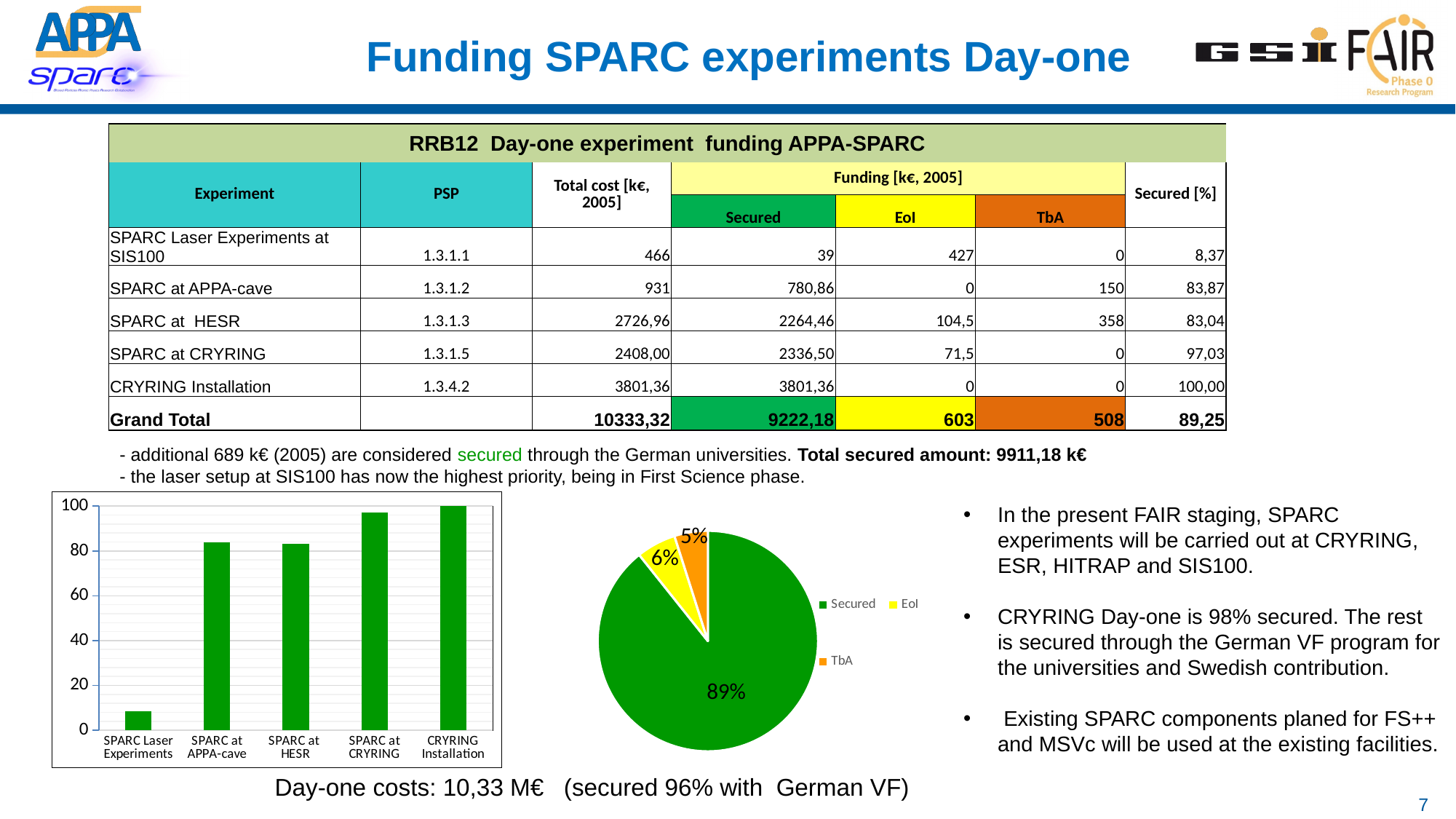
In the bar chart on the left, which is larger, the value for SPARC Laser Experiments or the value for SPARC at CRYRING? SPARC at CRYRING How many entries does the legend of the pie chart list? 3 In the bar chart on the left, is the value for SPARC Laser Experiments greater or less than 20? less In the pie chart, what share does the Secured slice have? 89% In the pie chart, what share does the EoI slice have? 6% In the bar chart on the left, is the value for SPARC at APPA-cave greater or less than 60? greater In the bar chart on the left, is the value for SPARC at CRYRING greater or less than 80? greater In the bar chart on the left, which category has the lowest bar? SPARC Laser Experiments What kind of chart is the chart on the left of the slide? bar chart In the bar chart on the left, how many categories are shown on the x axis? 5 In the pie chart, which slice is the smallest? TbA What kind of chart is the chart in the middle of the slide with the Secured, EoI and TbA legend? pie chart